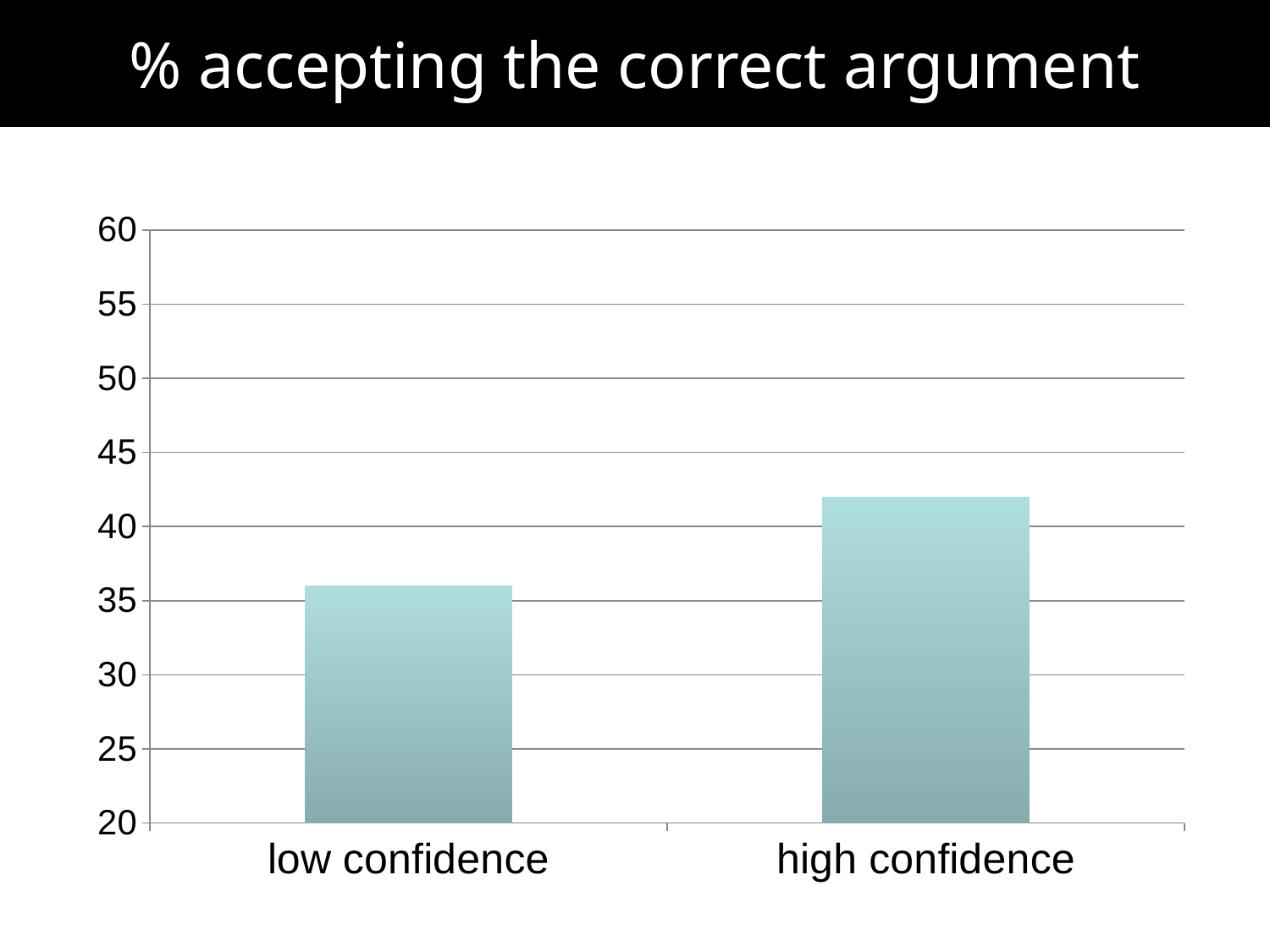
Which category has the highest value? high confidence Is the value for low confidence greater or less than 40? less Is the value for low confidence greater or less than 35? greater How many categories are plotted on the chart? 2 What is the lowest value shown on the vertical axis? 20 Do the values rise or fall from low confidence to high confidence? rise Is the value for high confidence greater or less than 45? less What kind of chart is shown on the slide? bar chart Which is larger, the value for low confidence or the value for high confidence? high confidence Which category has the lowest value? low confidence What is the title of the chart? % accepting the correct argument